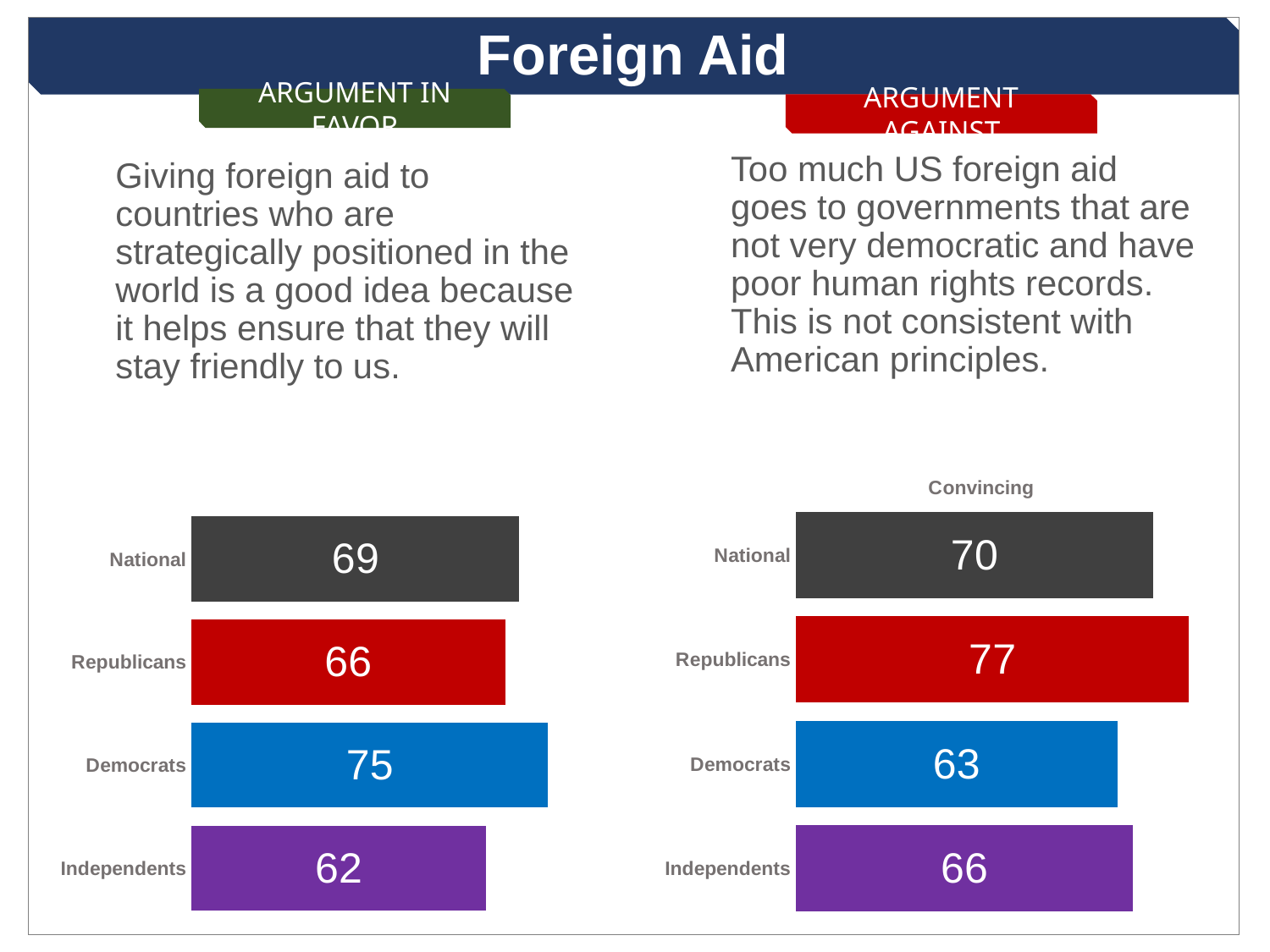
In the right chart (Argument Against), what is the difference between the Republicans value and the Democrats value? 14 In the left chart (Argument in Favor), which category has the lowest value? Independents In the right chart (Argument Against), which category has the lowest value? Democrats In the left chart (Argument in Favor), what is the value for Democrats? 75 In the left chart (Argument in Favor), which is larger, the value for Republicans or the value for Independents? Republicans In the left chart (Argument in Favor), what is the value for National? 69 In the right chart (Argument Against), what is the value for Republicans? 77 In the left chart (Argument in Favor), which category has the highest value? Democrats What kind of chart is the left chart (Argument in Favor)? Bar chart What colour is the Democrats bar in the right chart (Argument Against)? Blue In the right chart (Argument Against), what is the value for Independents? 66 How many categories are shown in the right chart (Argument Against)? 4